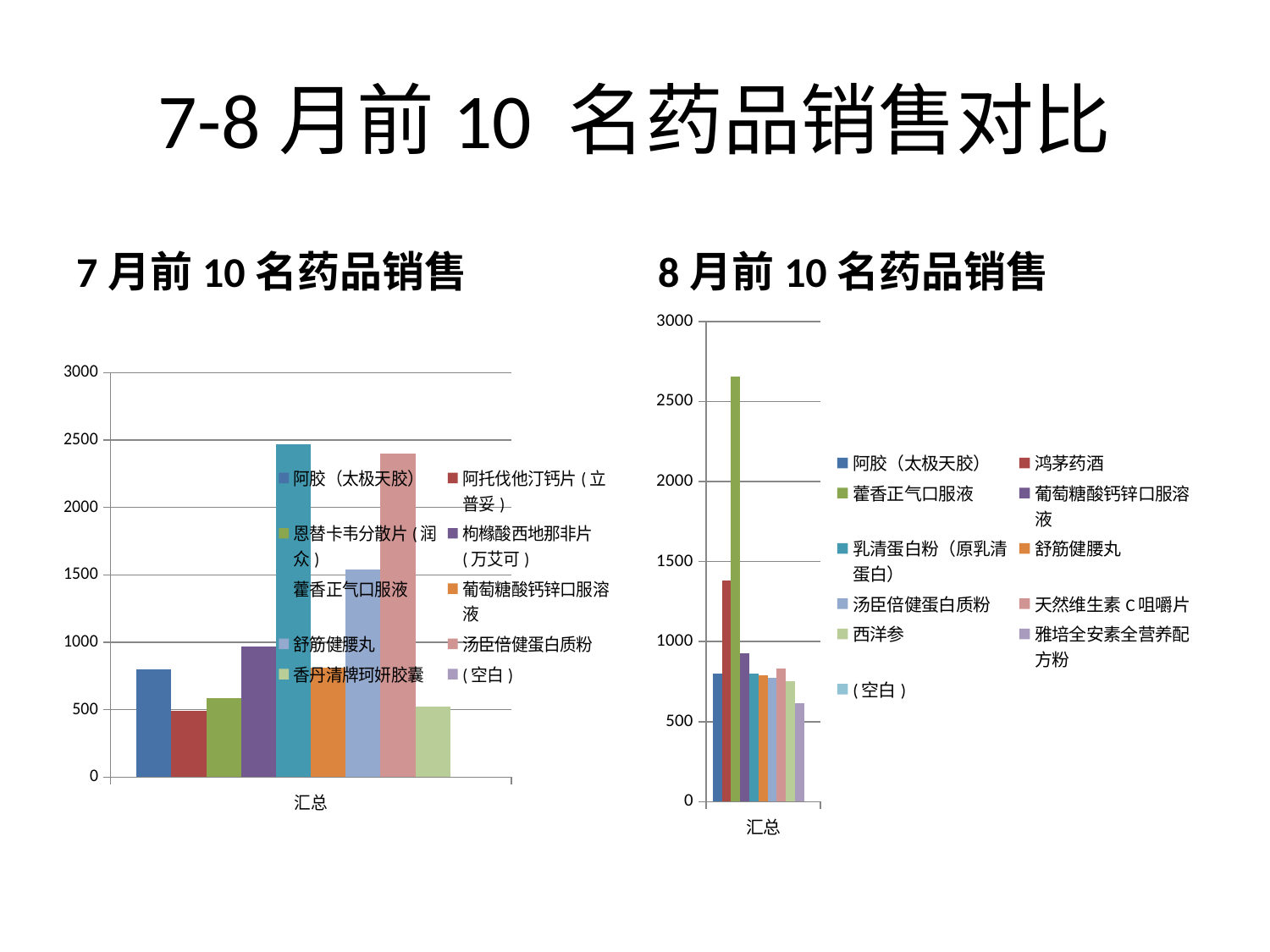
In the 7月前10名药品销售 chart, is the value for 阿胶（太极天胶） greater or less than 1000? less What is the category label shown on the x axis of the 8月前10名药品销售 chart? 汇总 In the 8月前10名药品销售 chart, which series has the lowest value? 雅培全安素全营养配方粉 In the 8月前10名药品销售 chart, is the value for 藿香正气口服液 greater or less than 2500? greater In the 8月前10名药品销售 chart, which is larger: 鸿茅药酒 or 阿胶（太极天胶）? 鸿茅药酒 In the 8月前10名药品销售 chart, is the value for 鸿茅药酒 greater or less than 1000? greater In the 8月前10名药品销售 chart, which series has the highest value? 藿香正气口服液 How many series does the legend of the 7月前10名药品销售 chart list? 10 How many series does the legend of the 8月前10名药品销售 chart list? 11 In the 7月前10名药品销售 chart, which is larger: 汤臣倍健蛋白质粉 or 阿胶（太极天胶）? 汤臣倍健蛋白质粉 What kind of chart is the 7月前10名药品销售 chart? bar chart